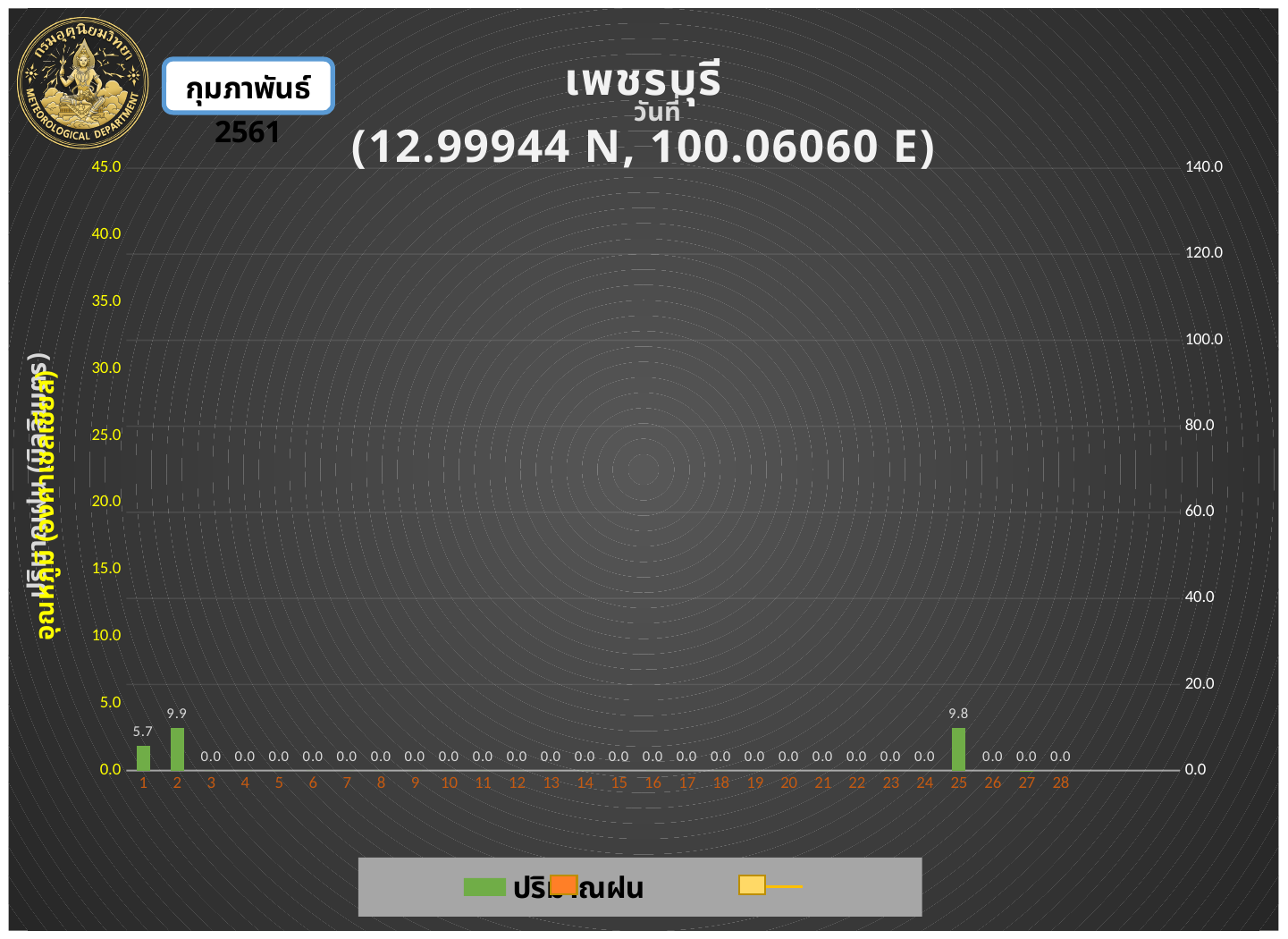
What is the difference between the values for day 25 and day 1? 4.1 What is the value for day 2? 9.9 What is the value for day 1? 5.7 What is the value for day 25? 9.8 How many days are shown on the x axis? 28 What kind of chart is this? bar chart Which day has the highest value? 2 What is the highest tick value on the right-hand axis? 140.0 Which is larger, the value for day 1 or the value for day 25? day 25 What is the value for day 10? 0.0 What is the difference between the values for day 2 and day 1? 4.2 Is the value for day 2 greater or less than 5.0 on the left axis? greater